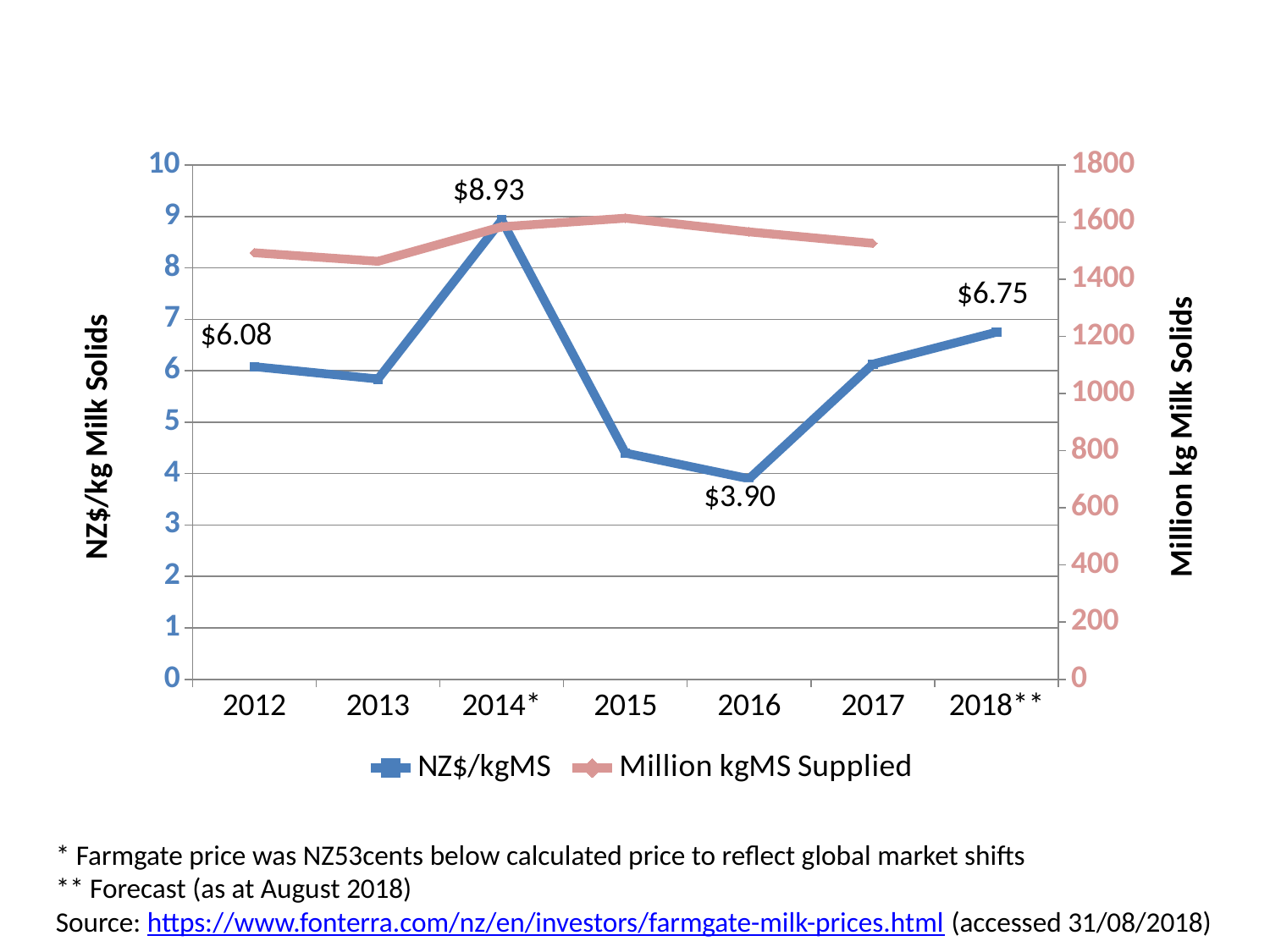
How many series does the legend list? 2 What is the difference between the NZ$/kgMS values for 2014* and 2016? $5.03 How many years are shown on the x axis? 7 What is the NZ$/kgMS value for 2012? $6.08 What is the NZ$/kgMS value for 2014*? $8.93 Which is larger, the NZ$/kgMS value for 2012 or for 2018**? 2018** What is the NZ$/kgMS value for 2016? $3.90 Is the Million kgMS Supplied value for 2015 greater or less than 1400? greater In which year is the NZ$/kgMS value highest? 2014* Is the NZ$/kgMS value for 2015 greater or less than 5? less What is the forecast NZ$/kgMS value for 2018**? $6.75 In which year is the NZ$/kgMS value lowest? 2016